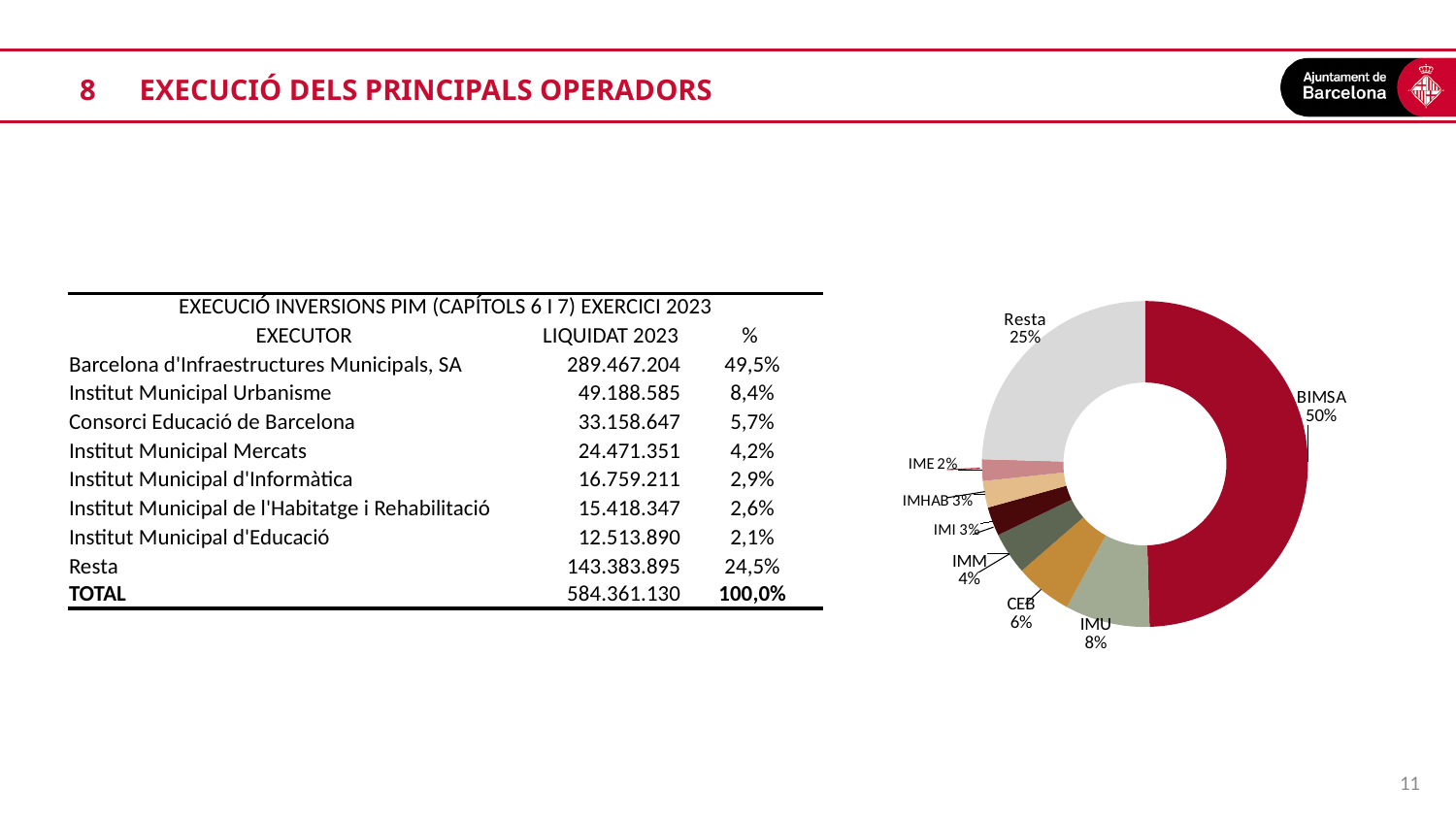
What share of the doughnut chart does IME represent? 2% Which slice of the doughnut chart is the largest? BIMSA What share of the doughnut chart does CEB represent? 6% What kind of chart is shown on the slide? doughnut chart In the doughnut chart, which is larger, the IMU slice or the CEB slice? IMU In the doughnut chart, what is the difference in percentage points between the BIMSA slice and the Resta slice? 25 Which slice of the doughnut chart is the smallest? IME What share of the doughnut chart does IMU represent? 8% What share of the doughnut chart does BIMSA represent? 50% What share of the doughnut chart does Resta represent? 25% In the doughnut chart, what is the difference in percentage points between the IMM slice and the IME slice? 2 How many slices does the doughnut chart have? 8